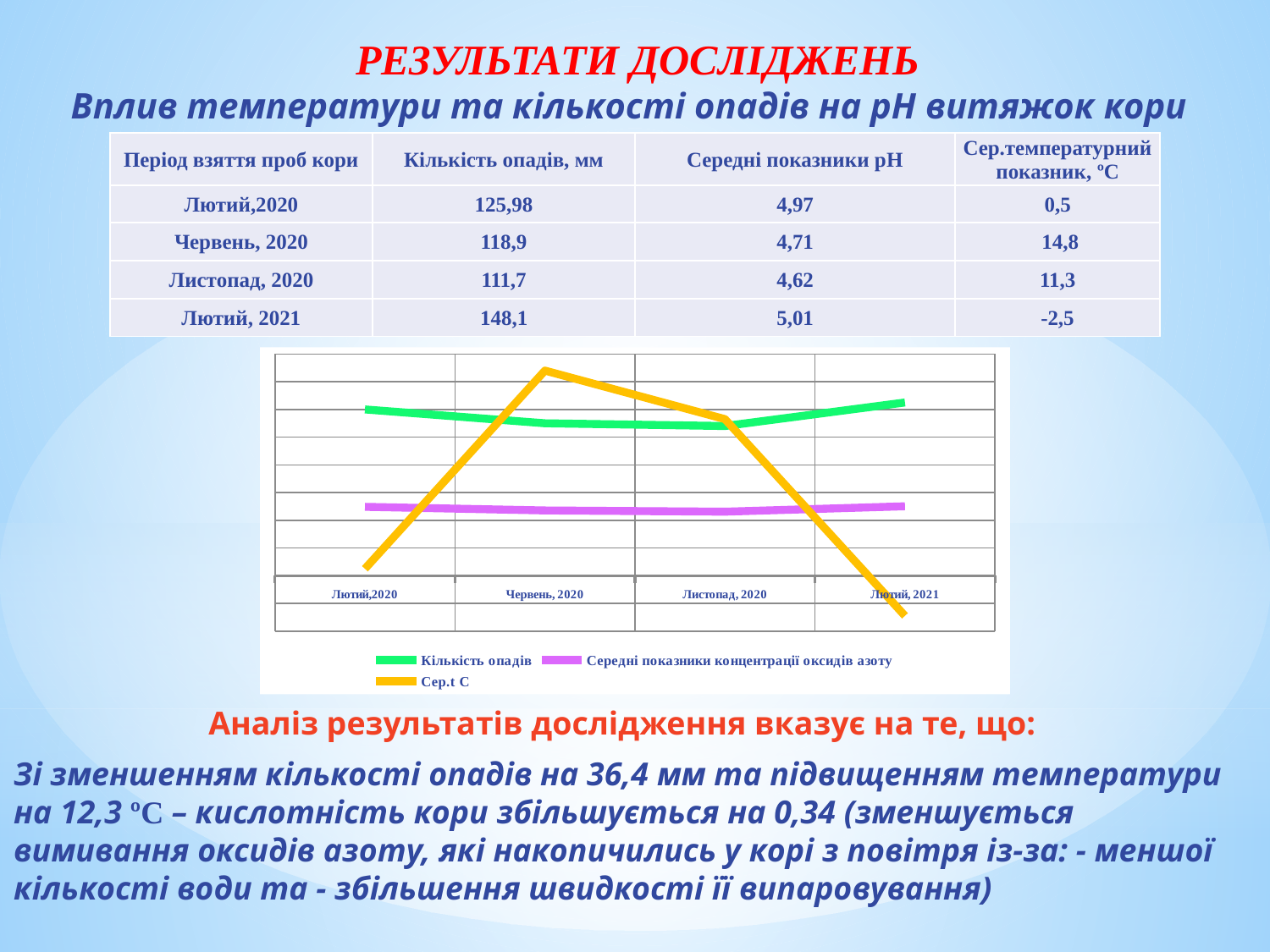
Does the Сер.t C series rise or fall from Червень, 2020 to Лютий, 2021? fall Which series is drawn in yellow on the chart? Сер.t C How many categories are shown along the x axis of the chart? 4 At which category does the Кількість опадів series reach its highest point? Лютий, 2021 At Лютий,2020, which series is plotted higher: Кількість опадів or Середні показники концентрації оксидів азоту? Кількість опадів What kind of chart is shown on the slide? line chart Which series is drawn in green on the chart? Кількість опадів At which category does the Сер.t C series reach its lowest point? Лютий, 2021 At Листопад, 2020, which series is plotted higher: Сер.t C or Середні показники концентрації оксидів азоту? Сер.t C Does the Сер.t C series rise or fall from Лютий,2020 to Червень, 2020? rise At which category does the Сер.t C series reach its highest point? Червень, 2020 How many series does the chart legend list? 3